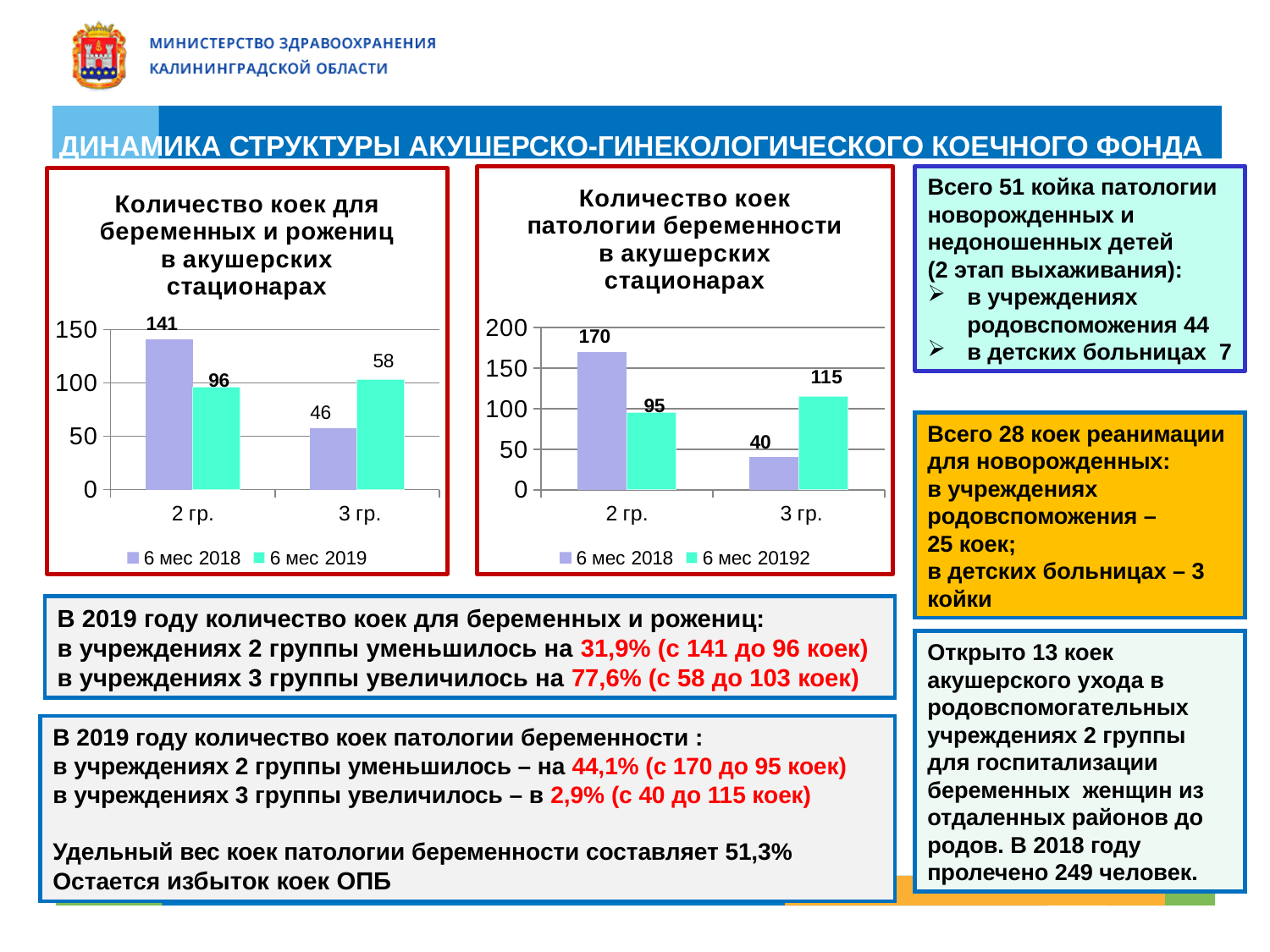
In the right chart (Количество коек патологии беременности в акушерских стационарах), which bar is the lowest? 3 гр., 6 мес 2018 (40) In the right chart (Количество коек патологии беременности в акушерских стационарах), what is the difference between the 6 мес 2018 and 6 мес 2019 values for 2 гр.? 75 In the left chart (Количество коек для беременных и рожениц в акушерских стационарах), what is the difference between the 6 мес 2018 and 6 мес 2019 values for 2 гр.? 45 How many series does the legend of the left chart (Количество коек для беременных и рожениц в акушерских стационарах) list? 2 In the right chart (Количество коек патологии беременности в акушерских стационарах), which category has the larger 6 мес 2019 value, 2 гр. or 3 гр.? 3 гр. In the right chart (Количество коек патологии беременности в акушерских стационарах), what is the value for 2 гр. in the 6 мес 2018 series? 170 In the right chart (Количество коек патологии беременности в акушерских стационарах), what is the value for 3 гр. in the 6 мес 2019 series? 115 What kind of chart is the left chart (Количество коек для беременных и рожениц в акушерских стационарах)? Bar chart In the left chart (Количество коек для беременных и рожениц в акушерских стационарах), what is the value for 2 гр. in the 6 мес 2018 series? 141 In the left chart (Количество коек для беременных и рожениц в акушерских стационарах), what is the value for 2 гр. in the 6 мес 2019 series? 96 In the right chart (Количество коек патологии беременности в акушерских стационарах), which bar is the highest? 2 гр., 6 мес 2018 (170) In the left chart (Количество коек для беременных и рожениц в акушерских стационарах), is the 6 мес 2018 value for 3 гр. greater or less than 100? less